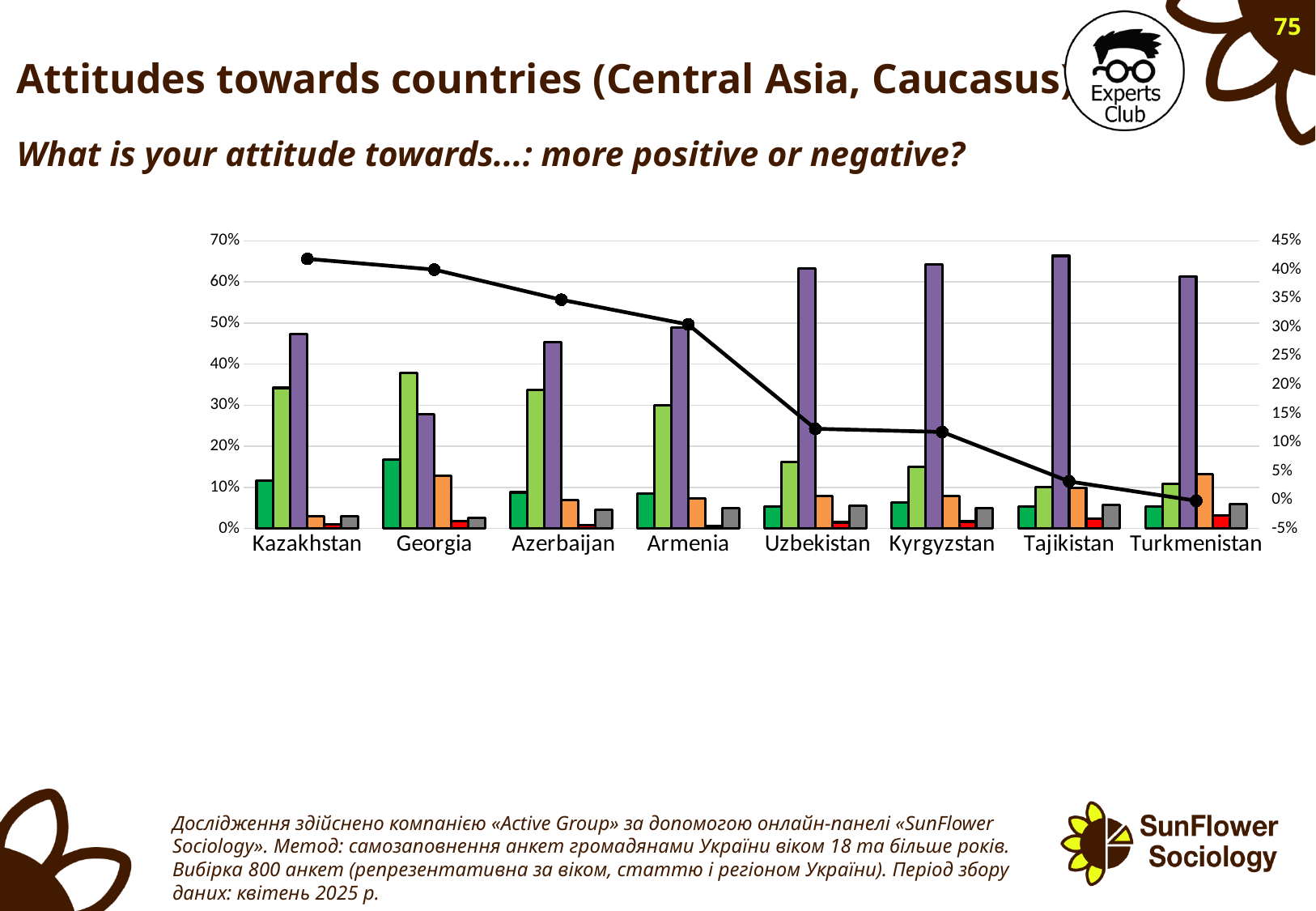
Is the black line point for Kazakhstan greater or less than 40% on the right axis? greater Which country has the lowest point on the black line? Turkmenistan How many countries are shown on the x axis of the chart? 8 Does the black line rise or fall from Kazakhstan to Turkmenistan? fall Is the light green bar for Georgia greater or less than 30% on the left axis? greater Is the purple bar larger for Kazakhstan or for Georgia? Kazakhstan Which country has the highest point on the black line? Kazakhstan Is the purple bar for Uzbekistan greater or less than 60% on the left axis? greater What question is the chart based on, according to the subtitle? What is your attitude towards...: more positive or negative? Which country has the tallest light green bar? Georgia What kind of chart is shown on the slide? bar chart with a line